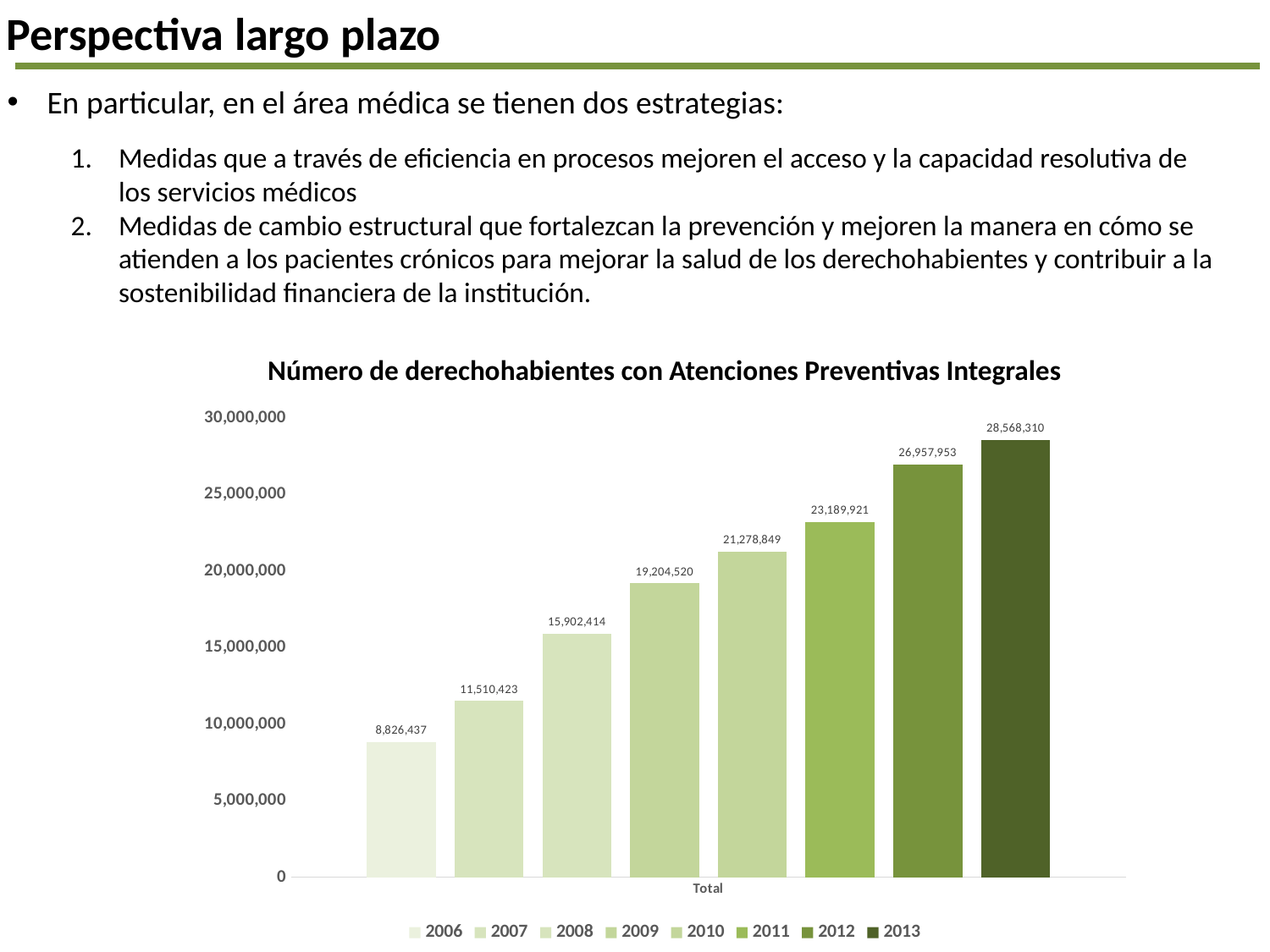
What is the title of the chart? Número de derechohabientes con Atenciones Preventivas Integrales What is the difference between the values for 2008 and 2007? 4,391,991 What is the value for 2006 in the chart? 8,826,437 How many series does the legend list? 8 Is the value for 2012 greater or less than 25,000,000? greater Which year has the lowest value in the chart? 2006 Which is larger, the value for 2010 or the value for 2011? 2011 Which year has the highest value in the chart? 2013 What is the difference between the values for 2013 and 2012? 1,610,357 What is the value for 2013 in the chart? 28,568,310 What kind of chart is shown on the slide? Bar chart What is the value for 2009 in the chart? 19,204,520